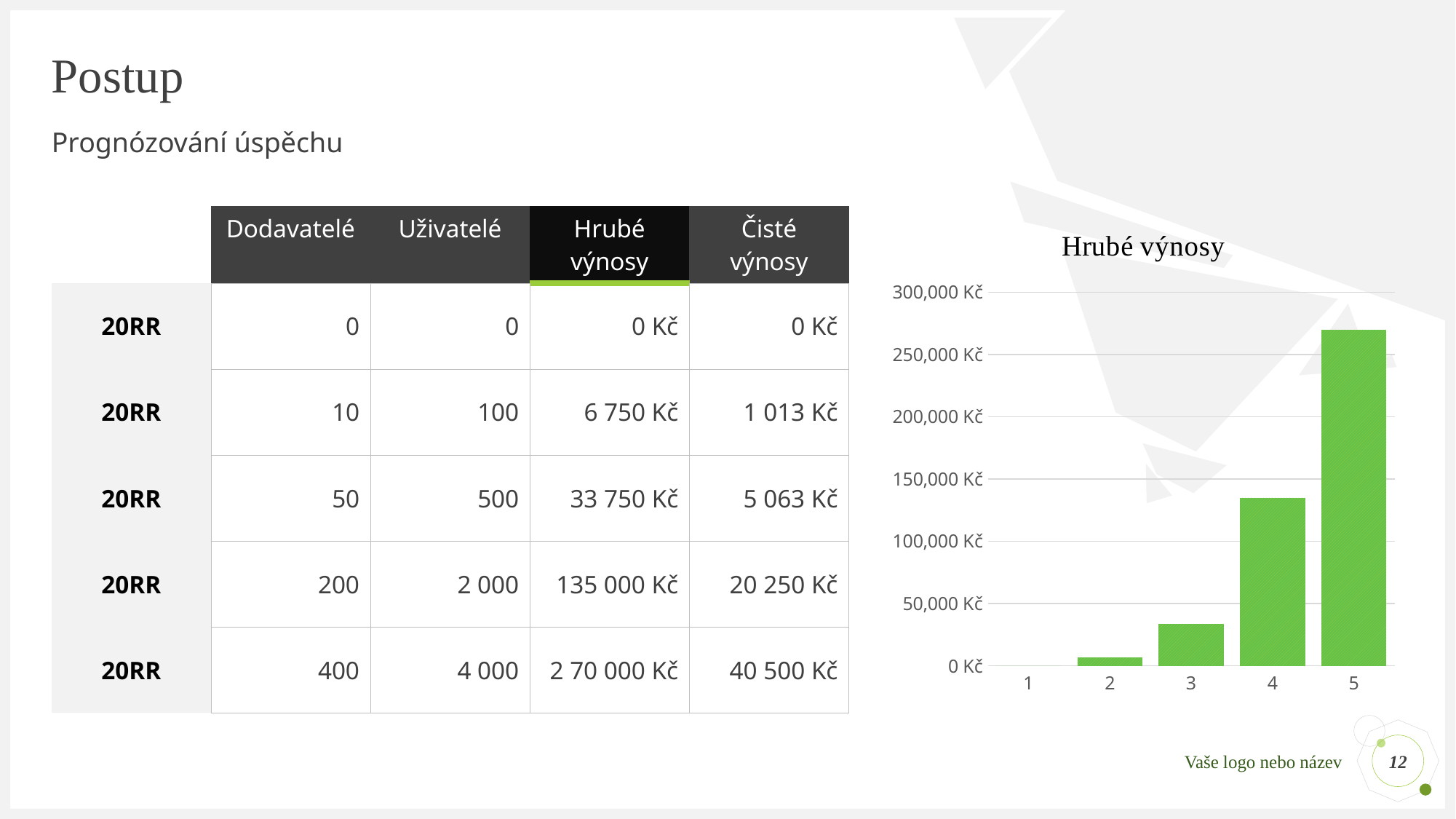
Is the value for category 3 greater or less than 50,000 Kč? less What kind of chart is shown on the slide? bar chart Is the value for category 5 greater or less than 250,000 Kč? greater What is the title of the chart on the slide? Hrubé výnosy Which category has the lowest bar in the Hrubé výnosy chart? 1 Is the value for category 4 greater or less than 100,000 Kč? greater Which category has the highest bar in the Hrubé výnosy chart? 5 How many bars does the Hrubé výnosy chart have? 5 Do the values in the Hrubé výnosy chart rise or fall from category 1 to category 5? rise Which is larger in the Hrubé výnosy chart, the value for category 3 or category 4? category 4 What colour are the bars in the Hrubé výnosy chart? green